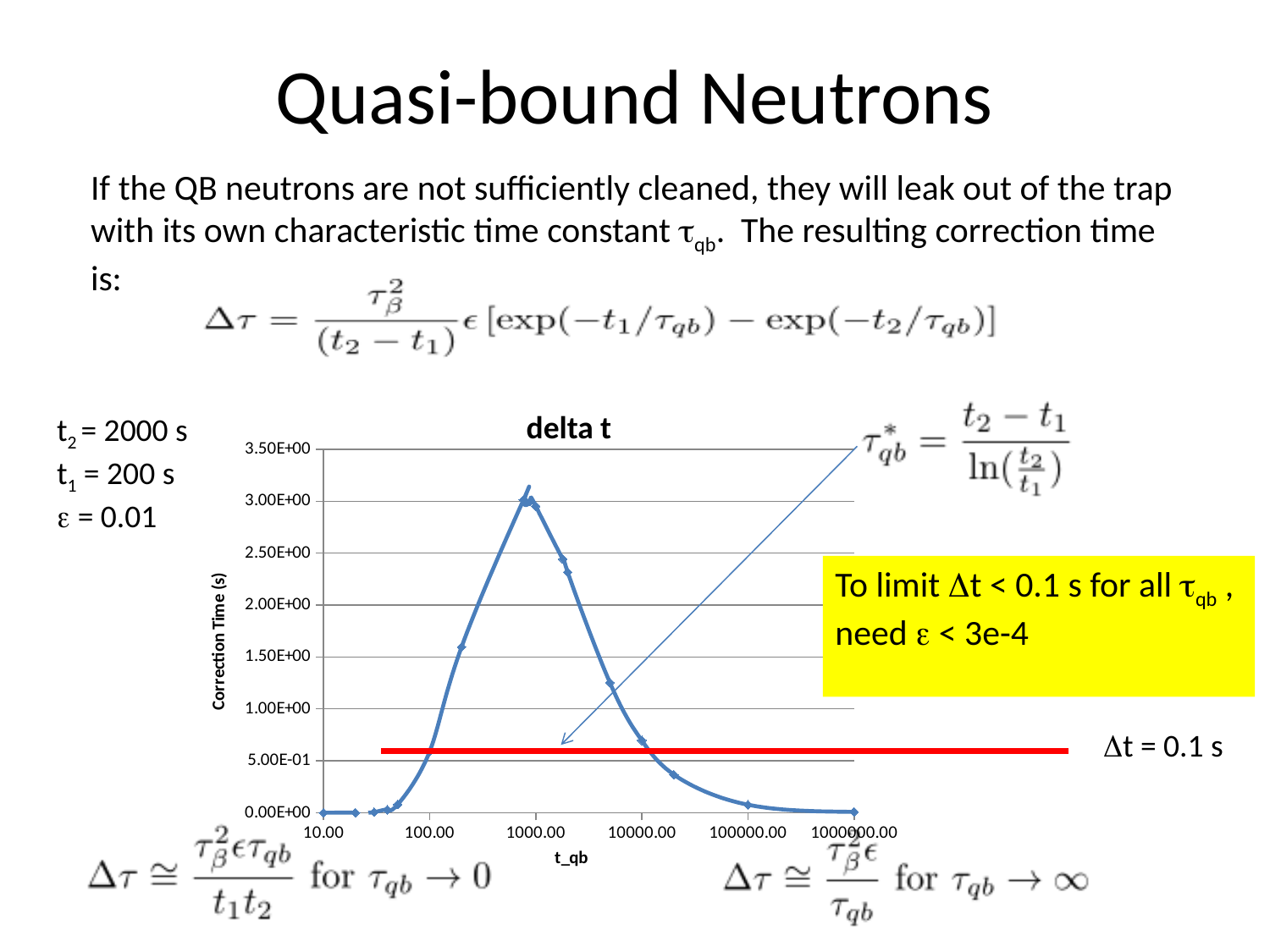
How does the correction time change as t_qb increases along the x axis? rises to a peak near 1000 then falls What is the title of the chart? delta t What kind of chart is shown on the slide? line chart Which has the larger correction time, t_qb = 200 or t_qb = 20000? t_qb = 200 Is the correction time at t_qb = 100000.00 greater or less than 5.00E-01? less Is the correction time at t_qb = 10000.00 greater or less than 1.00E+00? less What is the highest tick value shown on the y axis? 3.50E+00 Which has the larger correction time, t_qb = 1000.00 or t_qb = 10000.00? t_qb = 1000.00 Is the correction time at t_qb = 100.00 greater or less than 1.00E+00? less What is the lowest tick value shown on the x axis? 10.00 What is the label of the y axis of the chart? Correction Time (s)